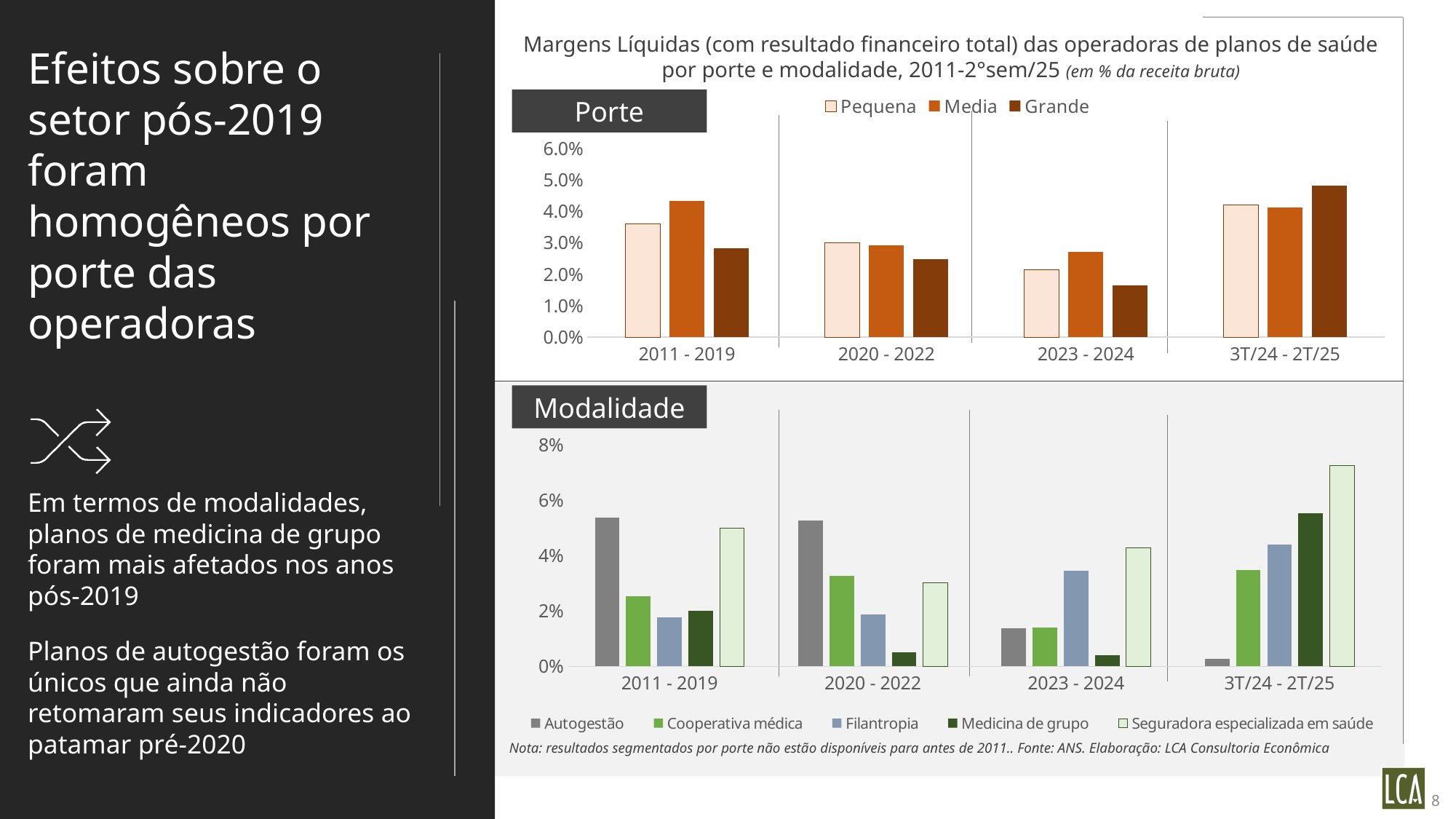
On the Modalidade chart, how many series does the legend list? 5 On the Porte chart, in which period is the Grande series lowest? 2023 - 2024 On the Modalidade chart, in 2023 - 2024, which is larger: Filantropia or Autogestão? Filantropia On the Porte chart, which series has the highest value in 3T/24 - 2T/25? Grande On the Porte chart, how many periods are shown on the x axis? 4 On the Modalidade chart, which series has the highest value in 3T/24 - 2T/25? Seguradora especializada em saúde On the Porte chart, what kind of chart is used? bar chart On the Porte chart, is the value for Grande in 2023 - 2024 greater or less than 2.0%? less On the Modalidade chart, does the Autogestão series rise or fall across the periods from 2011 - 2019 to 3T/24 - 2T/25? fall On the Porte chart, is the value for Media in 2011 - 2019 greater or less than 4.0%? greater On the Porte chart, how many series does the legend list? 3 On the Modalidade chart, is the value for Medicina de grupo in 2020 - 2022 greater or less than 2%? less